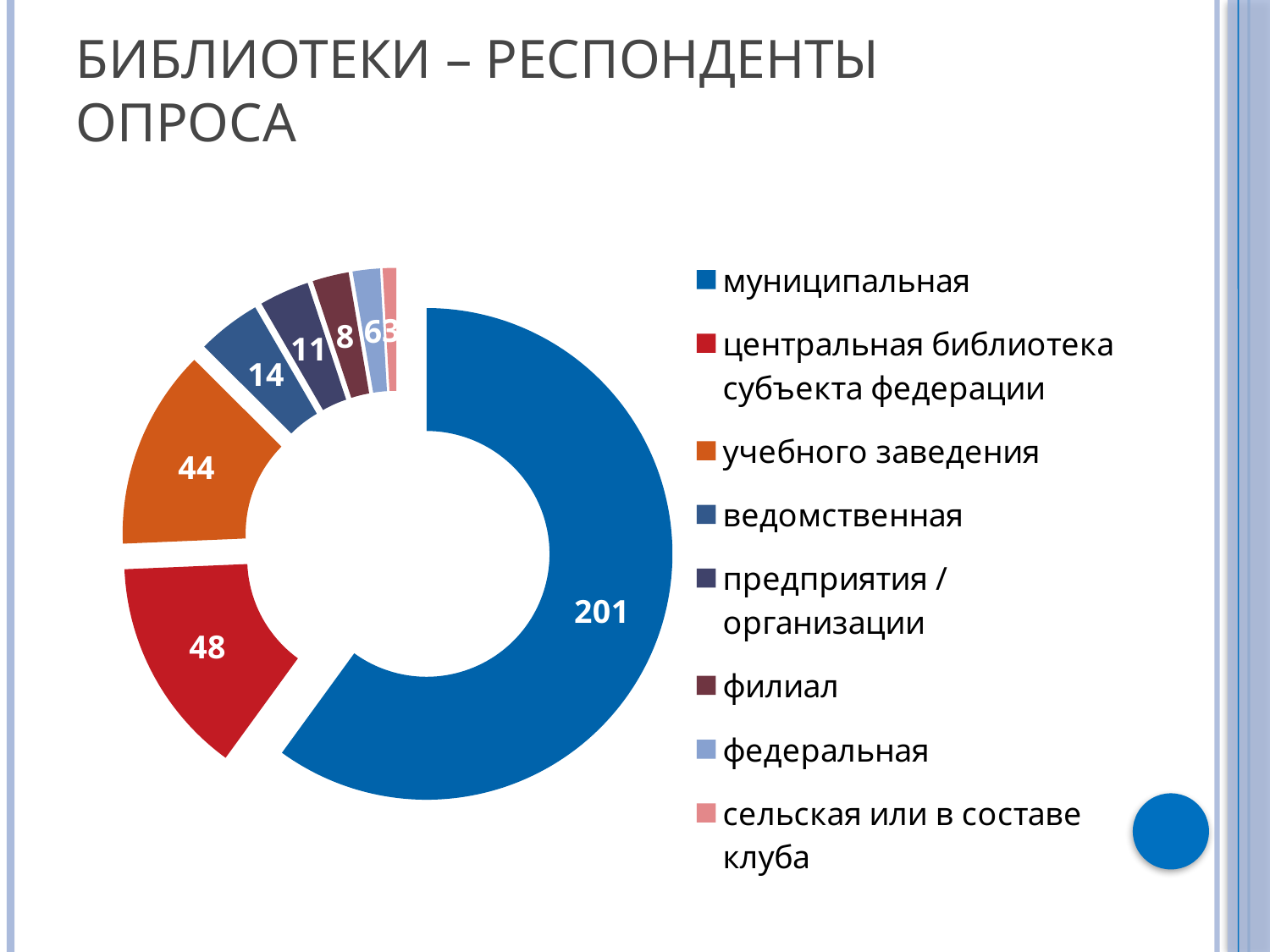
What is the value for ведомственная? 14 Which category has the lowest value? сельская или в составе клуба What kind of chart is shown on the slide? Doughnut (pie) chart What is the value for центральная библиотека субъекта федерации? 48 Which category has the highest value? муниципальная What is the value for учебного заведения? 44 What is the value for филиал? 8 What is the difference between the values for центральная библиотека субъекта федерации and учебного заведения? 4 How many categories does the chart show? 8 Which is larger, the value for учебного заведения or the value for ведомственная? учебного заведения What is the value for муниципальная? 201 What is the value for предприятия / организации? 11